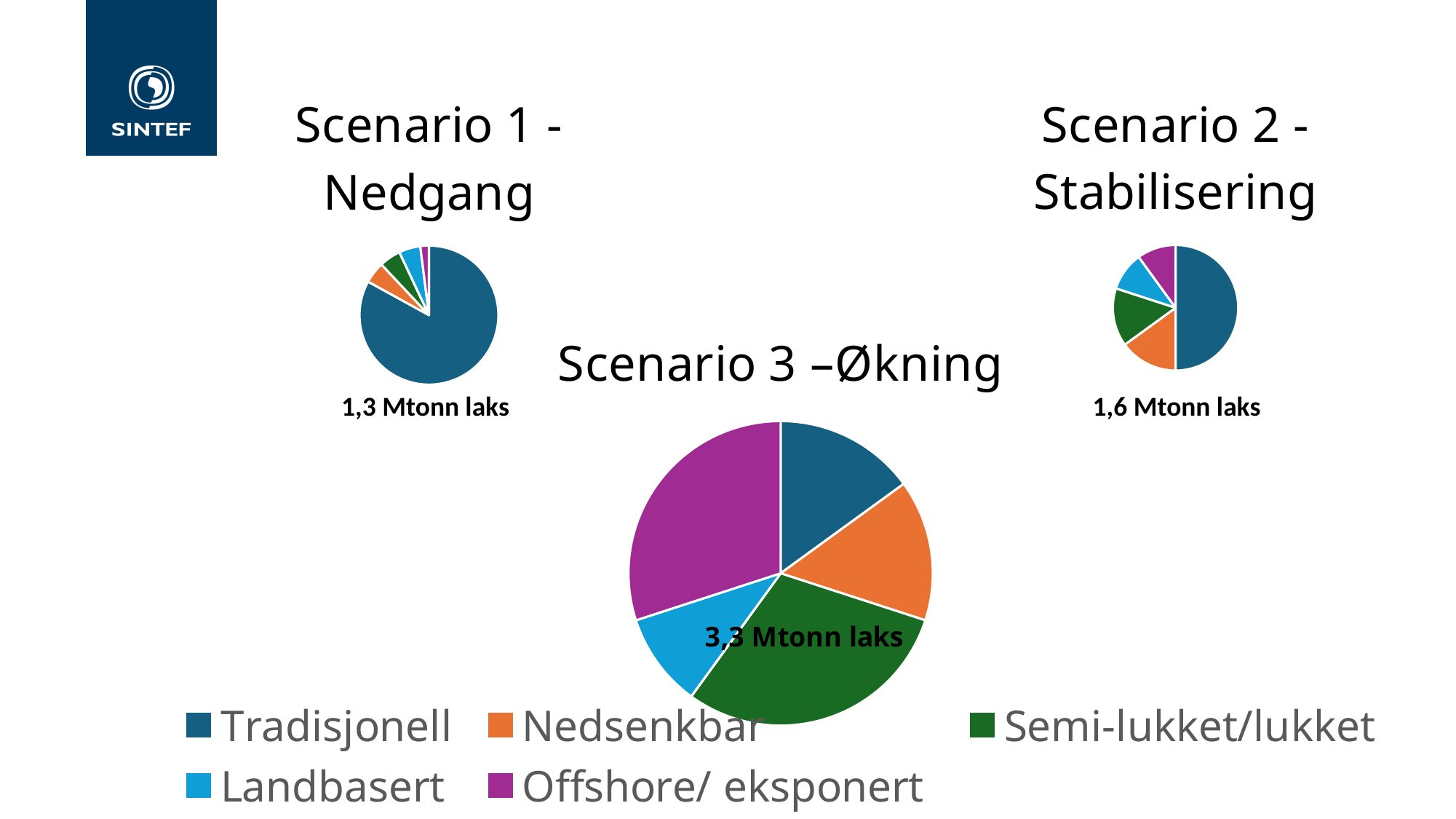
In the Scenario 2 - Stabilisering chart, which category has the largest slice? Tradisjonell Which colour represents Semi-lukket/lukket in the legend? Dark green In the Scenario 1 - Nedgang chart, which category has the largest slice? Tradisjonell In the Scenario 3 – Økning chart, which slice is larger: Tradisjonell or Landbasert? Tradisjonell How many series does the legend list? 5 In the Scenario 1 - Nedgang chart, which category has the smallest slice? Offshore/ eksponert What total salmon production is printed under the Scenario 1 - Nedgang chart? 1,3 Mtonn laks In the Scenario 3 – Økning chart, which category has the smallest slice? Landbasert What total salmon production is printed under the Scenario 2 - Stabilisering chart? 1,6 Mtonn laks What kind of chart is used for Scenario 1 - Nedgang? Pie chart What total salmon production is printed on the Scenario 3 – Økning chart? 3,3 Mtonn laks How many slices does the Scenario 3 – Økning pie chart have? 5